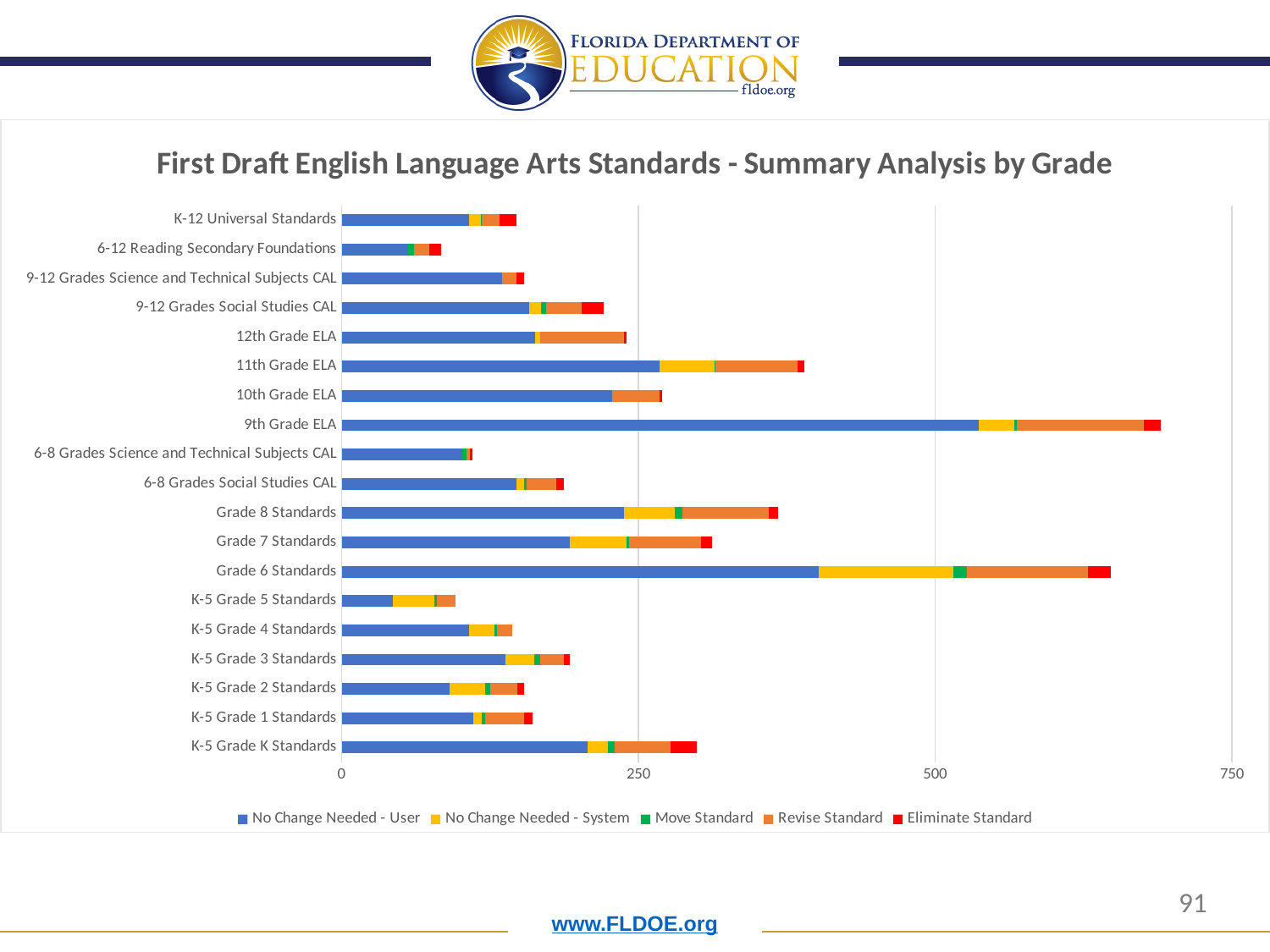
What kind of chart is shown on the slide? Stacked bar chart How many categories are listed on the vertical axis of the chart? 19 What is the title of the chart? First Draft English Language Arts Standards - Summary Analysis by Grade Which category has the shortest total bar? 6-12 Reading Secondary Foundations Is the total bar length for 9th Grade ELA greater or less than 500? greater Is the total bar length for K-5 Grade K Standards greater or less than 250? greater Is the total bar length for 11th Grade ELA greater or less than 500? less Which has the longer total bar, Grade 6 Standards or Grade 8 Standards? Grade 6 Standards Which category has the longest total bar? 9th Grade ELA Which has the longer total bar, 11th Grade ELA or 10th Grade ELA? 11th Grade ELA How many series does the chart's legend list? 5